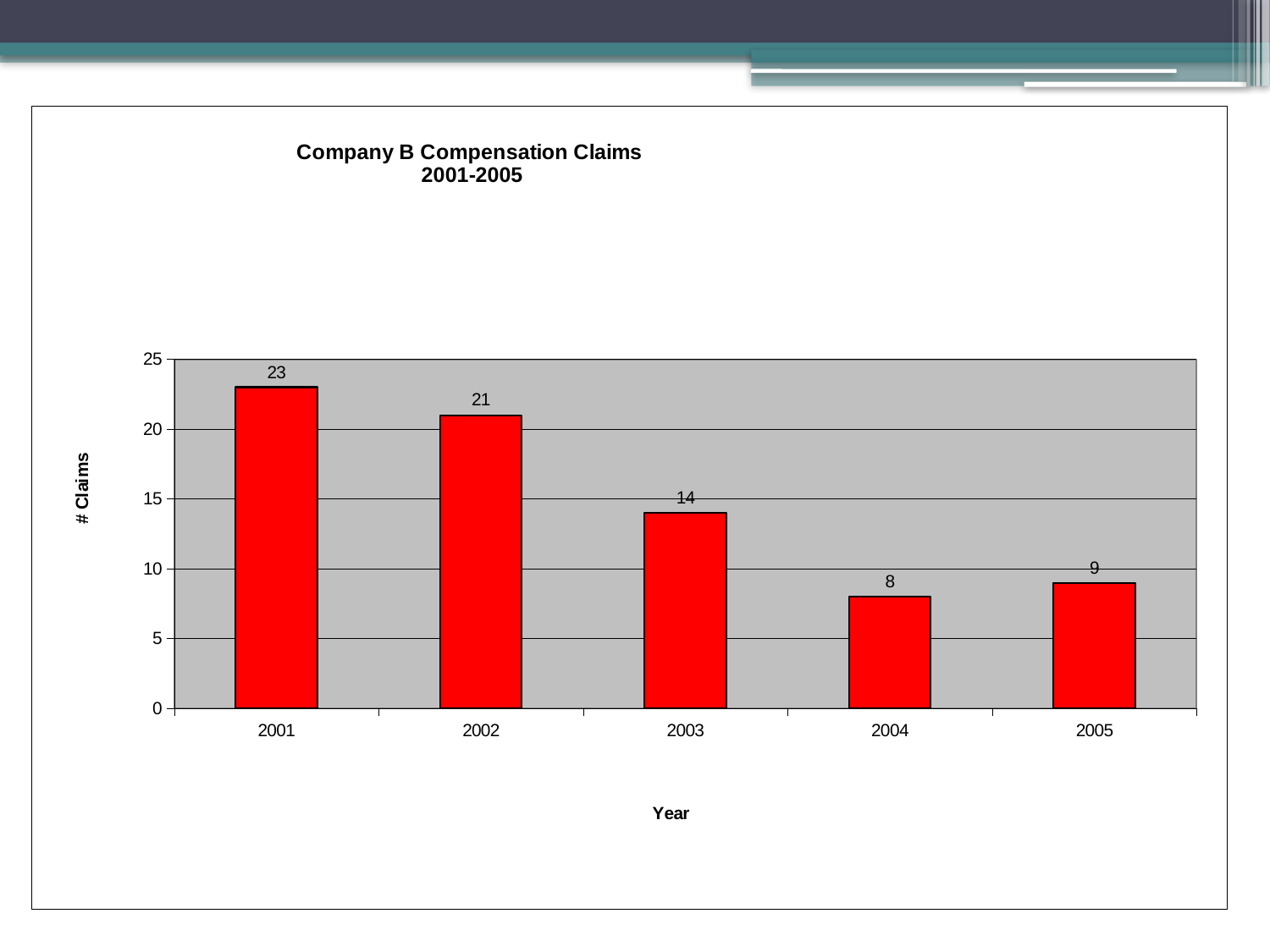
What is the title of the chart? Company B Compensation Claims 2001-2005 What is the number of claims shown for 2005? 9 What kind of chart is shown on the slide? bar chart Which year has the lowest number of claims? 2004 What is the difference in claims between 2001 and 2005? 14 How many more claims were there in 2002 than in 2003? 7 Which year had more claims, 2004 or 2005? 2005 How many years are shown on the x axis? 5 What is the number of claims shown for 2003? 14 Is the value for 2003 greater or less than 15? less How many compensation claims did Company B have in 2001? 23 Which year has the highest number of claims? 2001